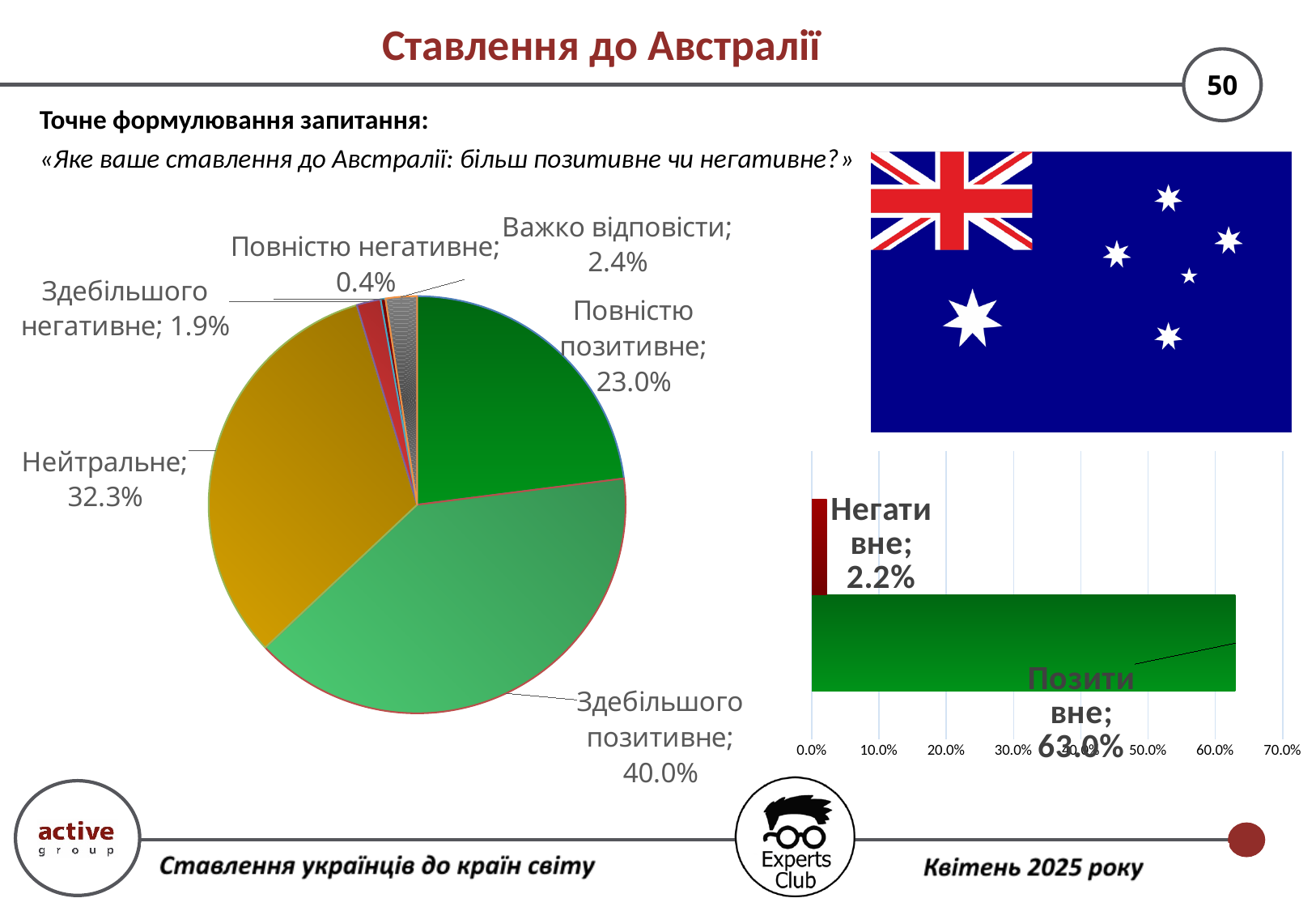
In the pie chart on the left, what share is labelled for "Здебільшого позитивне"? 40.0% In the pie chart on the left, what is the difference between "Здебільшого позитивне" and "Повністю позитивне"? 17.0% In the pie chart on the left, which category has the smallest slice? Повністю негативне In the bar chart on the right, what value is shown for "Негативне"? 2.2% In the pie chart on the left, which is larger: "Нейтральне" or "Повністю позитивне"? Нейтральне In the pie chart on the left, what share is labelled for "Нейтральне"? 32.3% What type of chart is shown on the right side of the slide, below the flag? Bar chart How many slices does the pie chart on the left have? 6 In the pie chart on the left, which category has the largest slice? Здебільшого позитивне In the pie chart on the left, what share is labelled for "Повністю негативне"? 0.4% In the bar chart on the right, what is the difference between "Позитивне" and "Негативне"? 60.8% In the bar chart on the right, what value is shown for "Позитивне"? 63.0%